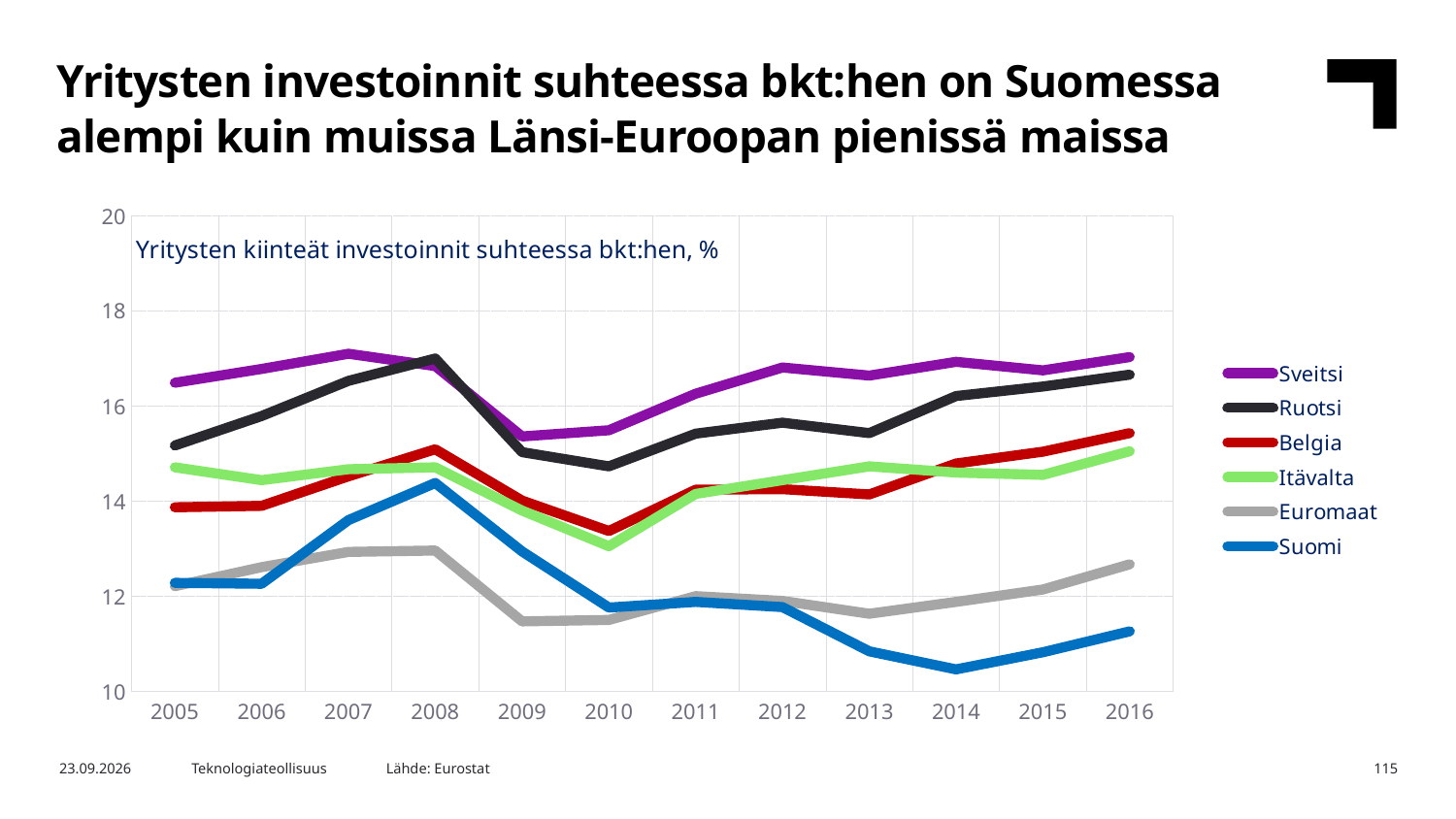
Is the value for Suomi in 2014 greater or less than 12? less Is the value for Euromaat in 2009 greater or less than 12? less Which series has the highest value in 2012? Sveitsi How many years are shown on the x axis? 12 In which year does Suomi reach its lowest value? 2014 In 2008, which is larger: Suomi or Euromaat? Suomi Which country has the lowest value in 2016? Suomi How many series does the legend list? 6 In 2014, which is larger: Suomi or Euromaat? Euromaat Is the value for Sveitsi in 2007 greater or less than 16? greater Does the value for Suomi rise or fall from 2008 to 2014? fall What kind of chart is shown on the slide? line chart